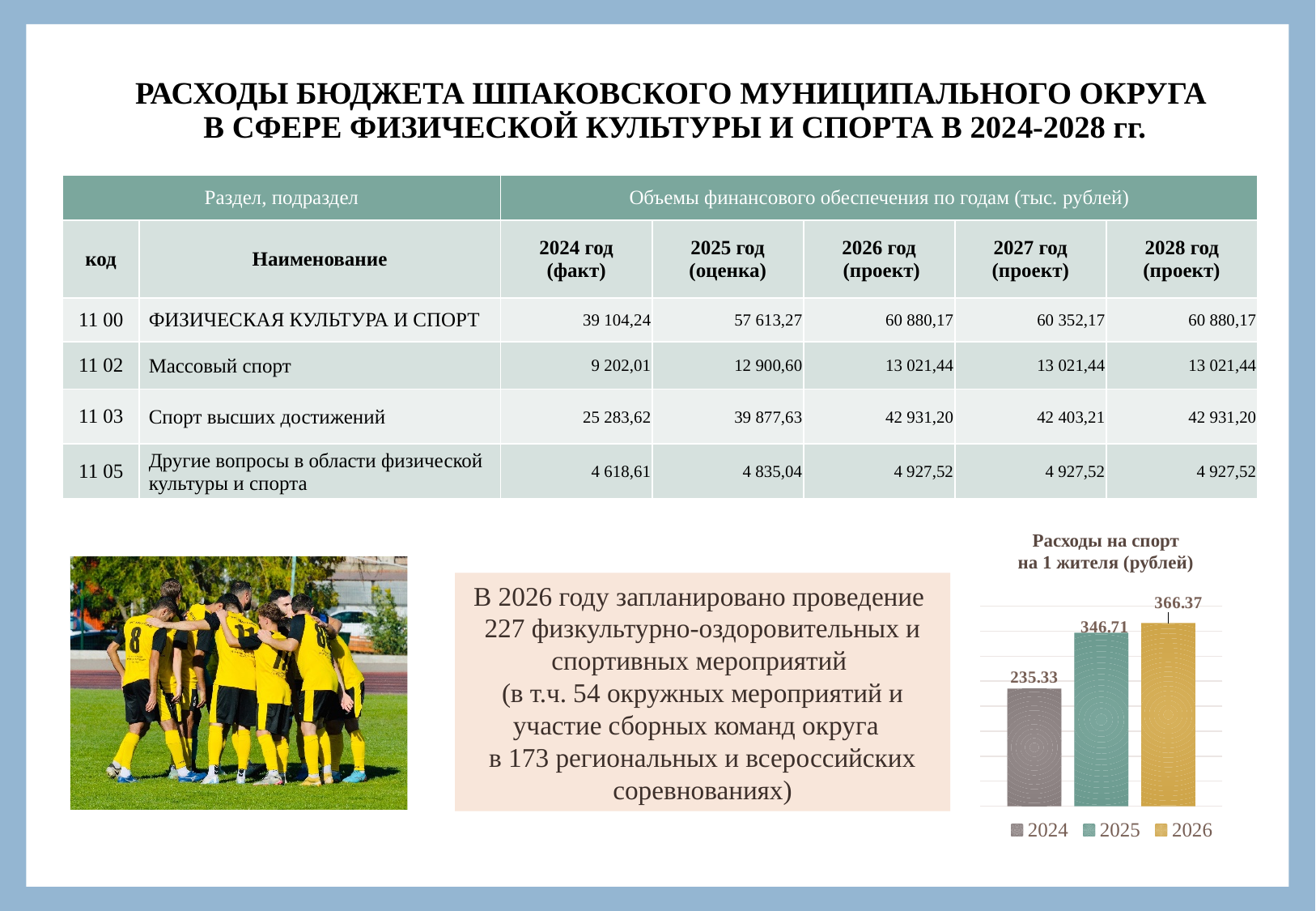
How many bars are shown in the chart 'Расходы на спорт на 1 жителя (рублей)'? 3 What is the value for 2024 in the chart 'Расходы на спорт на 1 жителя (рублей)'? 235.33 In the chart 'Расходы на спорт на 1 жителя (рублей)', what is the difference between the 2025 and 2024 values? 111.38 What is the value for 2025 in the chart 'Расходы на спорт на 1 жителя (рублей)'? 346.71 What type of chart is 'Расходы на спорт на 1 жителя (рублей)'? Bar chart Which year has the highest value in the chart 'Расходы на спорт на 1 жителя (рублей)'? 2026 In the chart 'Расходы на спорт на 1 жителя (рублей)', what is the difference between the 2026 and 2025 values? 19.66 Which year has the lowest value in the chart 'Расходы на спорт на 1 жителя (рублей)'? 2024 In the chart 'Расходы на спорт на 1 жителя (рублей)', which is larger: the value for 2024 or the value for 2025? 2025 How many entries does the legend of the chart 'Расходы на спорт на 1 жителя (рублей)' list? 3 What is the value for 2026 in the chart 'Расходы на спорт на 1 жителя (рублей)'? 366.37 In the chart 'Расходы на спорт на 1 жителя (рублей)', what is the difference between the 2026 and 2024 values? 131.04